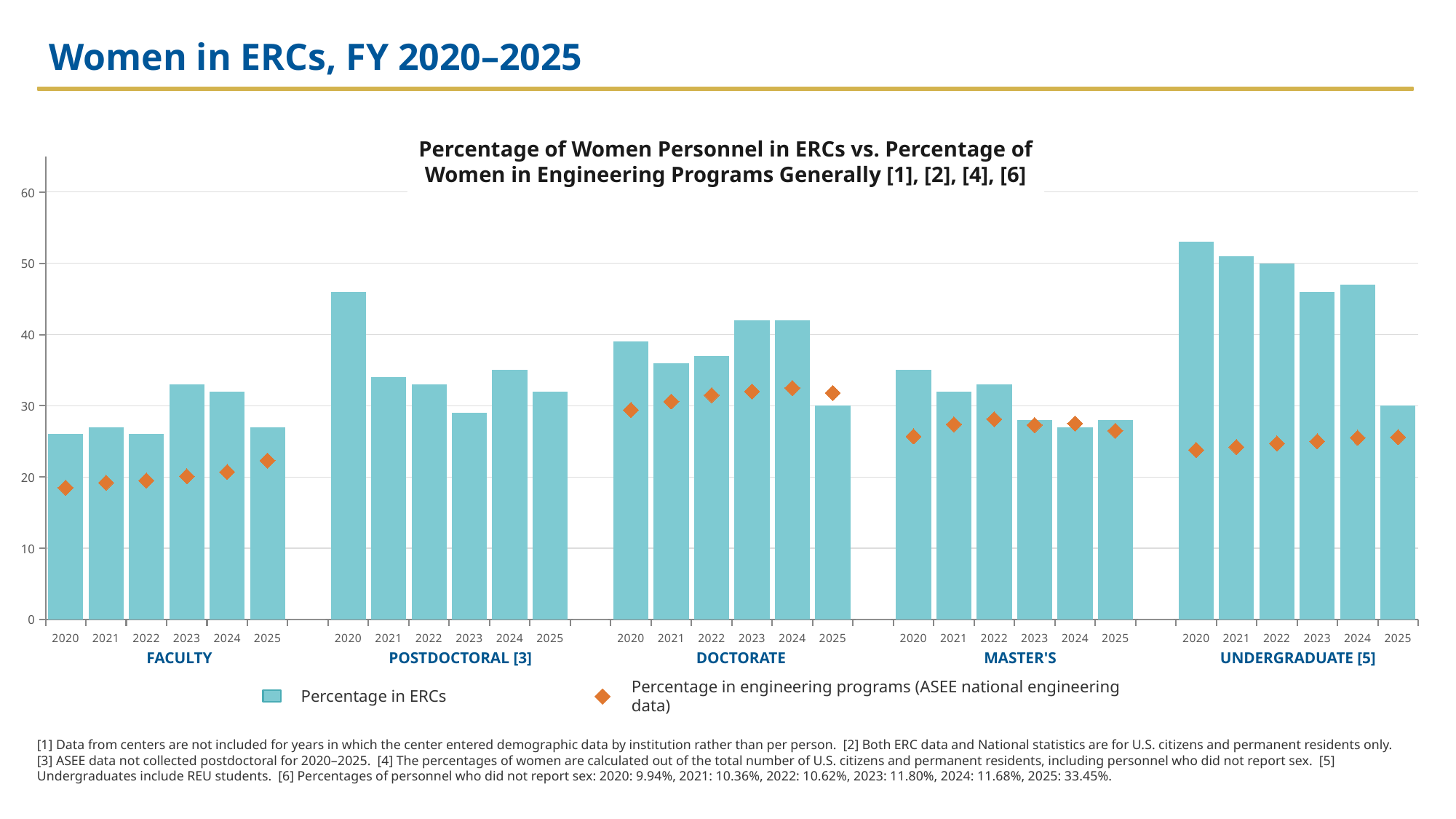
How many series does the legend list? 2 Which is larger, the Percentage in ERCs bar for Faculty 2023 or for Faculty 2020? Faculty 2023 Is the Percentage in ERCs bar for Faculty 2020 greater or less than 30? less How many personnel groups (Faculty, Postdoctoral, etc.) are shown along the x axis? 5 Which bar is the highest in the whole chart? Undergraduate 2020 Is the Percentage in ERCs bar for Postdoctoral 2020 greater or less than 40? greater Do the Percentage in ERCs bars for Undergraduate generally rise or fall from 2020 to 2025? fall Is the Percentage in ERCs bar for Undergraduate 2025 greater or less than 40? less Which is larger, the Percentage in ERCs bar for Doctorate 2023 or for Master's 2023? Doctorate 2023 What does the orange diamond marker represent according to the legend? Percentage in engineering programs (ASEE national engineering data) What kind of chart is shown on the slide? bar chart Within the Postdoctoral group, which year has the lowest Percentage in ERCs bar? 2023